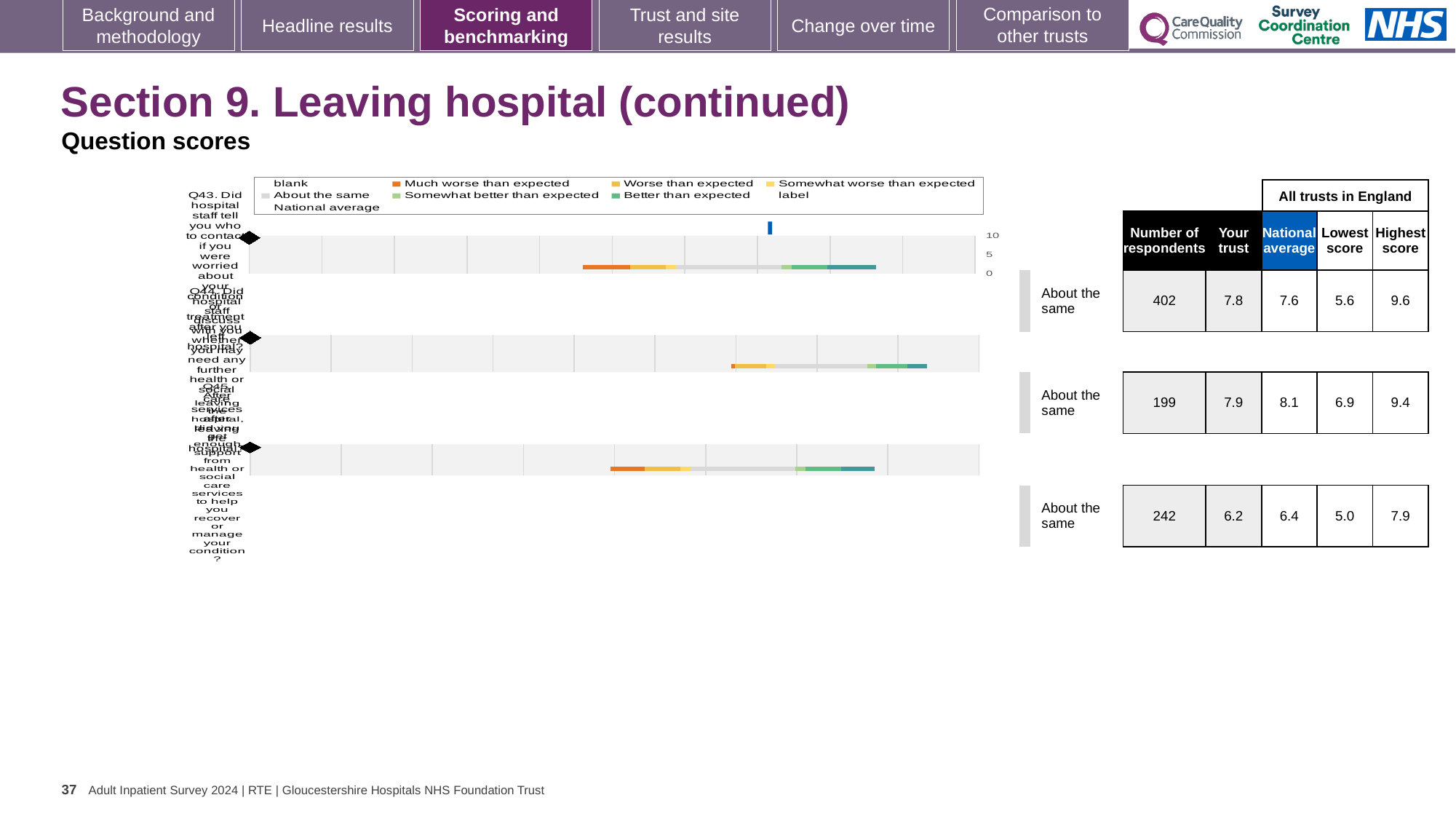
How many questions (rows) are plotted in the chart? 3 Which row has the largest number of respondents? Q43 (first row), 402 What is the national average for the third row (Q45)? 6.4 For the second row (Q44), which is larger: the 'Your trust' score or the national average? National average Which row has the lowest 'Your trust' score? Q45 (third row), 6.2 What is the 'Your trust' score for the second row (Q44)? 7.9 What is the difference between the 'Your trust' score and the national average for the first row (Q43)? 0.2 What benchmark category is shown for all three rows? About the same What is the number of respondents for the first row (Q43)? 402 What kind of chart is used to show the question scores on this slide? bar chart What is the highest score across all trusts in England for the first row (Q43)? 9.6